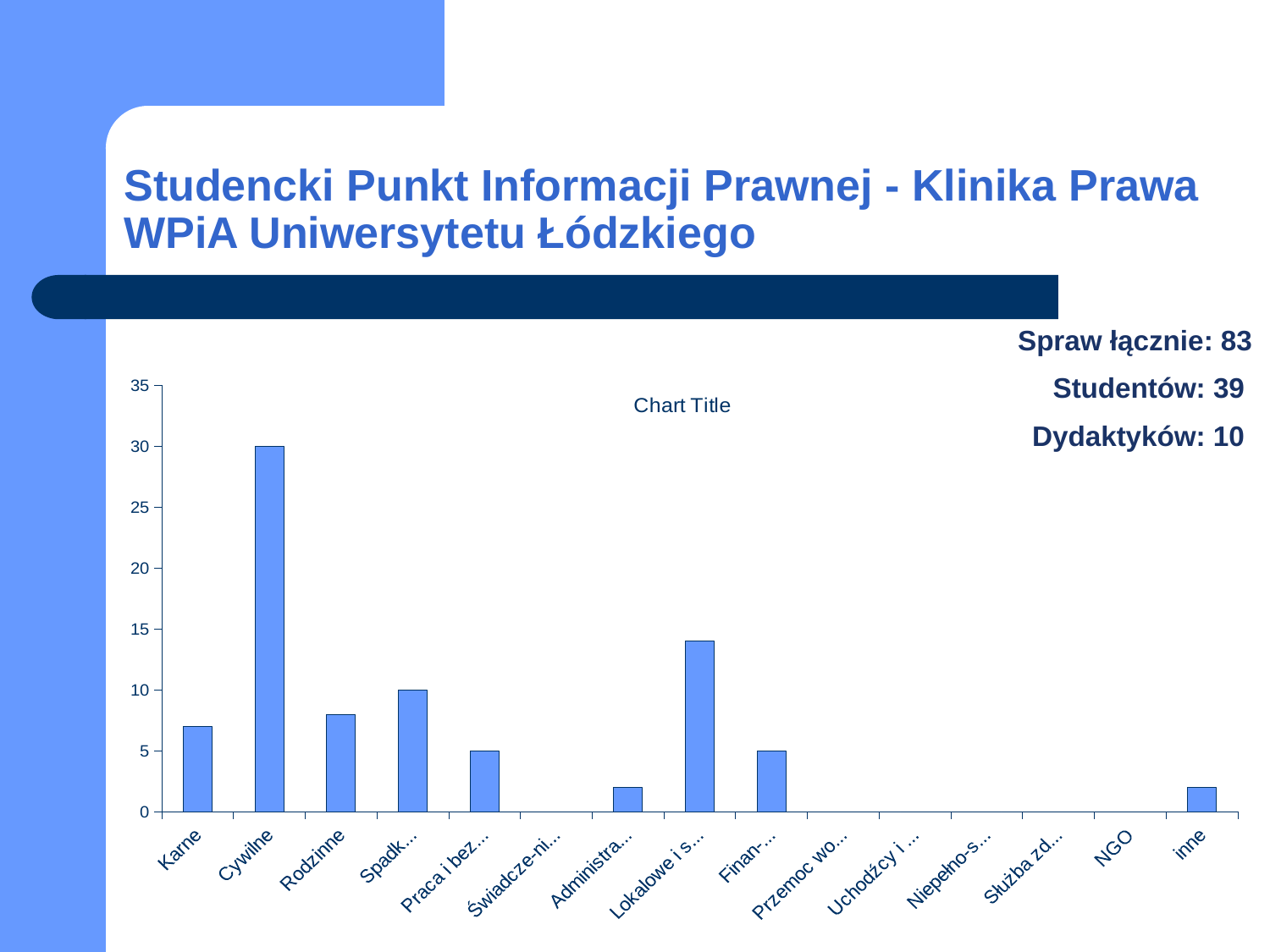
Which category has the highest bar? Cywilne What kind of chart is shown on the slide? bar chart What is the difference between the value for Cywilne and the value for Spadk...? 20 Is the value for Rodzinne greater or less than 5? greater Is the value for the category labelled Lokalowe i s... greater or less than 10? greater Which is larger, the value for Cywilne or the value for Lokalowe i s...? Cywilne Is the value for Karne greater or less than 10? less What is the value for Cywilne? 30 What is the value for the category labelled Spadk...? 10 How many categories are shown on the x axis? 15